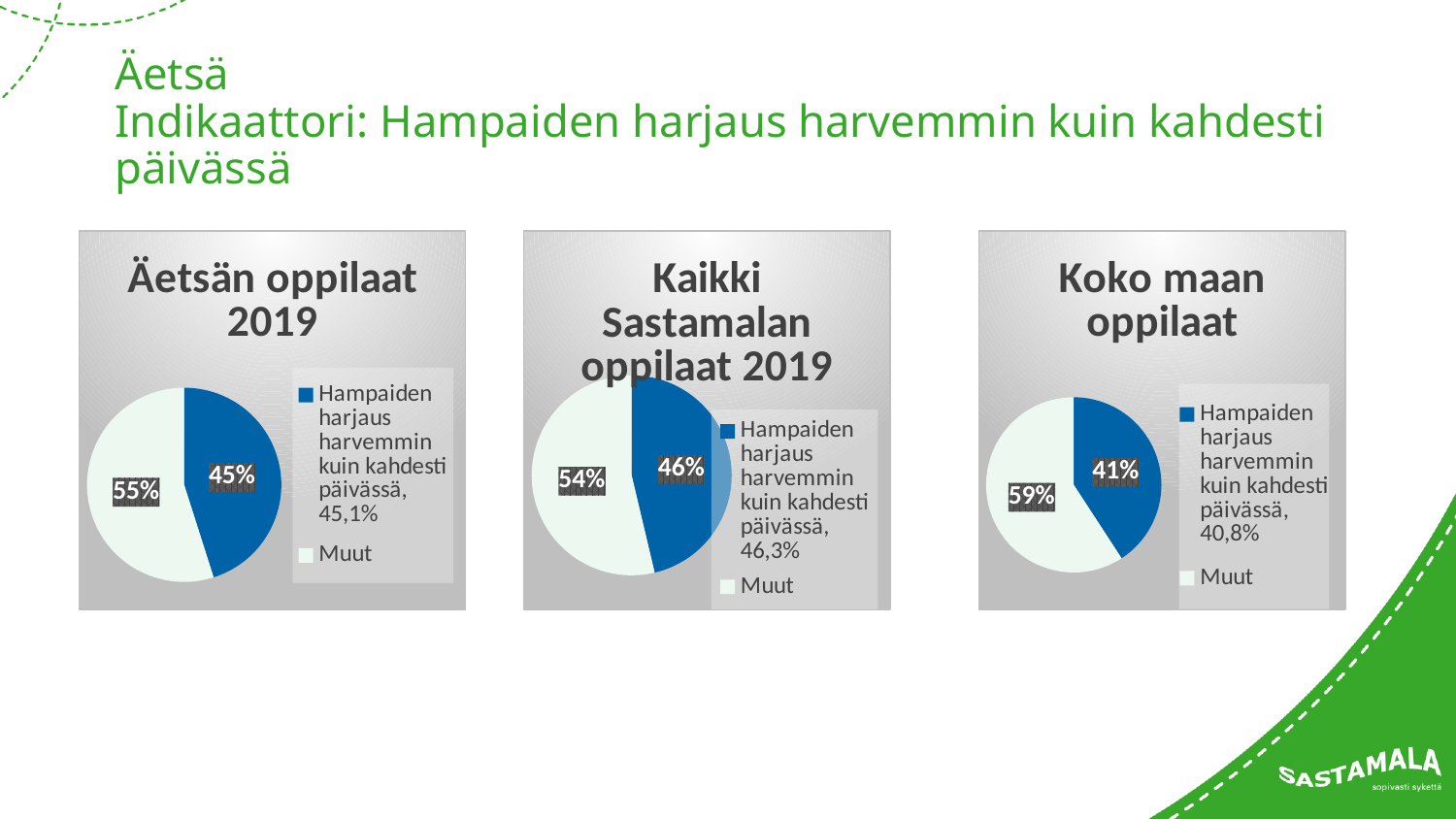
In the "Äetsän oppilaat 2019" chart, what share of the pie is labelled for "Hampaiden harjaus harvemmin kuin kahdesti päivässä"? 45% In the "Koko maan oppilaat" chart, what is the difference in percentage points between the "Muut" slice and the "Hampaiden harjaus harvemmin kuin kahdesti päivässä" slice? 18 In the "Äetsän oppilaat 2019" chart, which slice is larger, "Muut" or "Hampaiden harjaus harvemmin kuin kahdesti päivässä"? Muut In the "Koko maan oppilaat" chart, what percentage is shown for the "Hampaiden harjaus harvemmin kuin kahdesti päivässä" slice? 41% What kind of chart is the "Koko maan oppilaat" chart? Pie chart How many entries does the legend of the "Äetsän oppilaat 2019" chart list? 2 How many slices does the "Kaikki Sastamalan oppilaat 2019" pie chart have? 2 In the "Kaikki Sastamalan oppilaat 2019" chart, what share of the pie is "Muut"? 54% In the "Koko maan oppilaat" chart, what percentage is shown for the "Muut" slice? 59% In the "Äetsän oppilaat 2019" chart, what percentage is shown for the "Muut" slice? 55% In the "Koko maan oppilaat" chart, what exact percentage is given in the legend entry for "Hampaiden harjaus harvemmin kuin kahdesti päivässä"? 40,8% In the "Kaikki Sastamalan oppilaat 2019" chart, what percentage is shown for the "Hampaiden harjaus harvemmin kuin kahdesti päivässä" slice? 46%